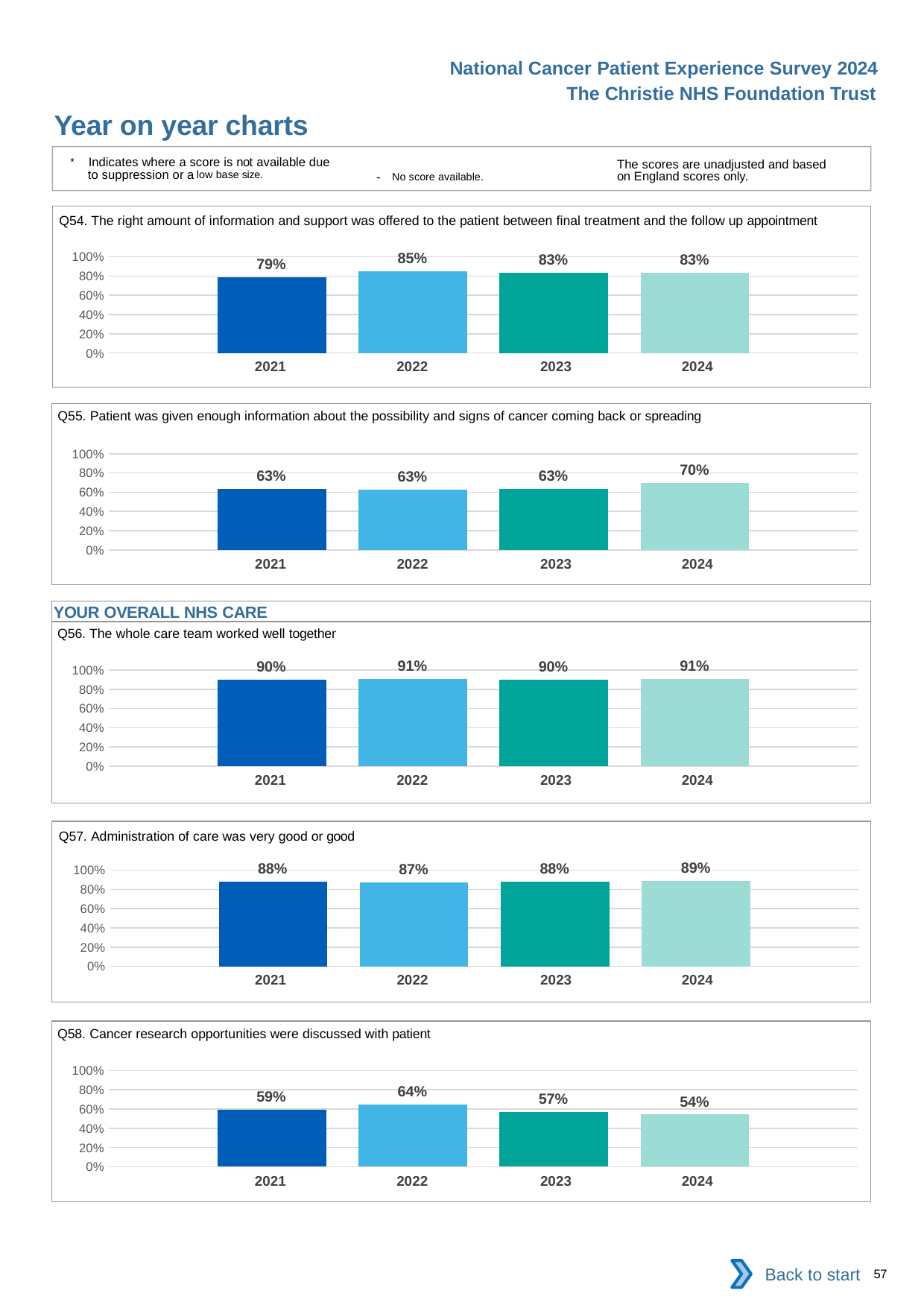
In the Q58 chart, what is the difference between the 2022 value and the 2024 value? 10% In the Q55 chart, what is the difference between the 2024 value and the 2023 value? 7% In the Q58 chart, which year has the highest value? 2022 In the Q54 chart, which year has the lowest value? 2021 How many charts are shown on the slide? 5 In the Q57 chart, which year has the lowest value? 2022 In the Q57 chart, what is the value for 2024? 89% In the Q58 chart, is the value for 2021 larger or smaller than the value for 2023? larger In the Q56 chart, what is the value for 2023? 90% In the Q54 chart, what is the value for 2022? 85% In the Q55 chart, which year has the highest value? 2024 In the Q55 chart, what is the value for 2024? 70%